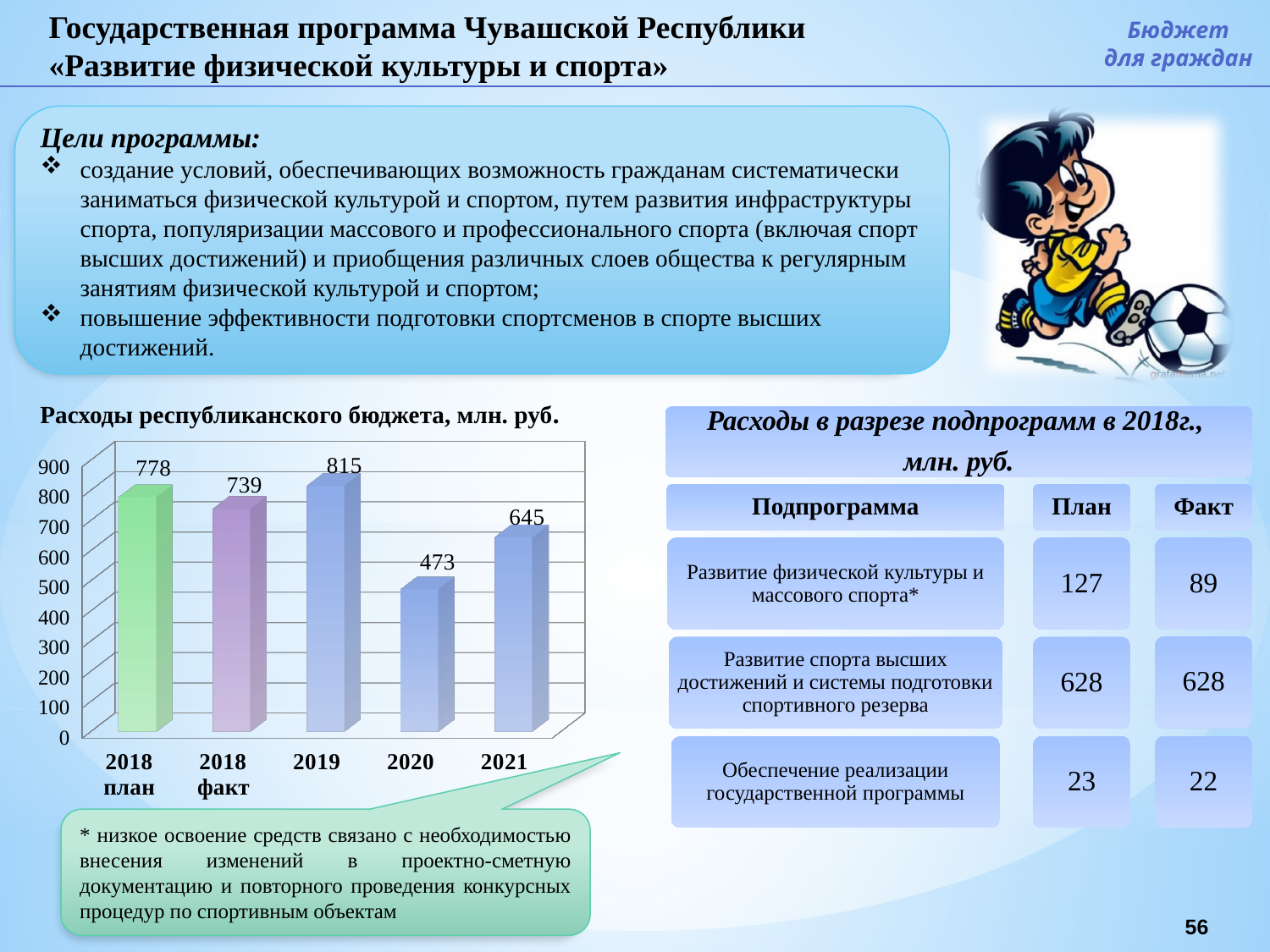
What kind of chart is shown on the slide? bar chart What is the difference between the 2019 and 2020 values? 342 What is the value for 2020 in the chart? 473 How many bars are shown in the chart? 5 What is the difference between the 2018 план and 2018 факт values? 39 Is the value for 2021 greater or less than 600? greater Which category has the lowest value in the chart? 2020 What is the value for 2018 план in the chart? 778 What is the title of the chart on the slide? Расходы республиканского бюджета, млн. руб. Which category has the highest value in the chart? 2019 Which is larger, the value for 2021 or the value for 2020? 2021 What is the value for 2019 in the chart 'Расходы республиканского бюджета, млн. руб.'? 815